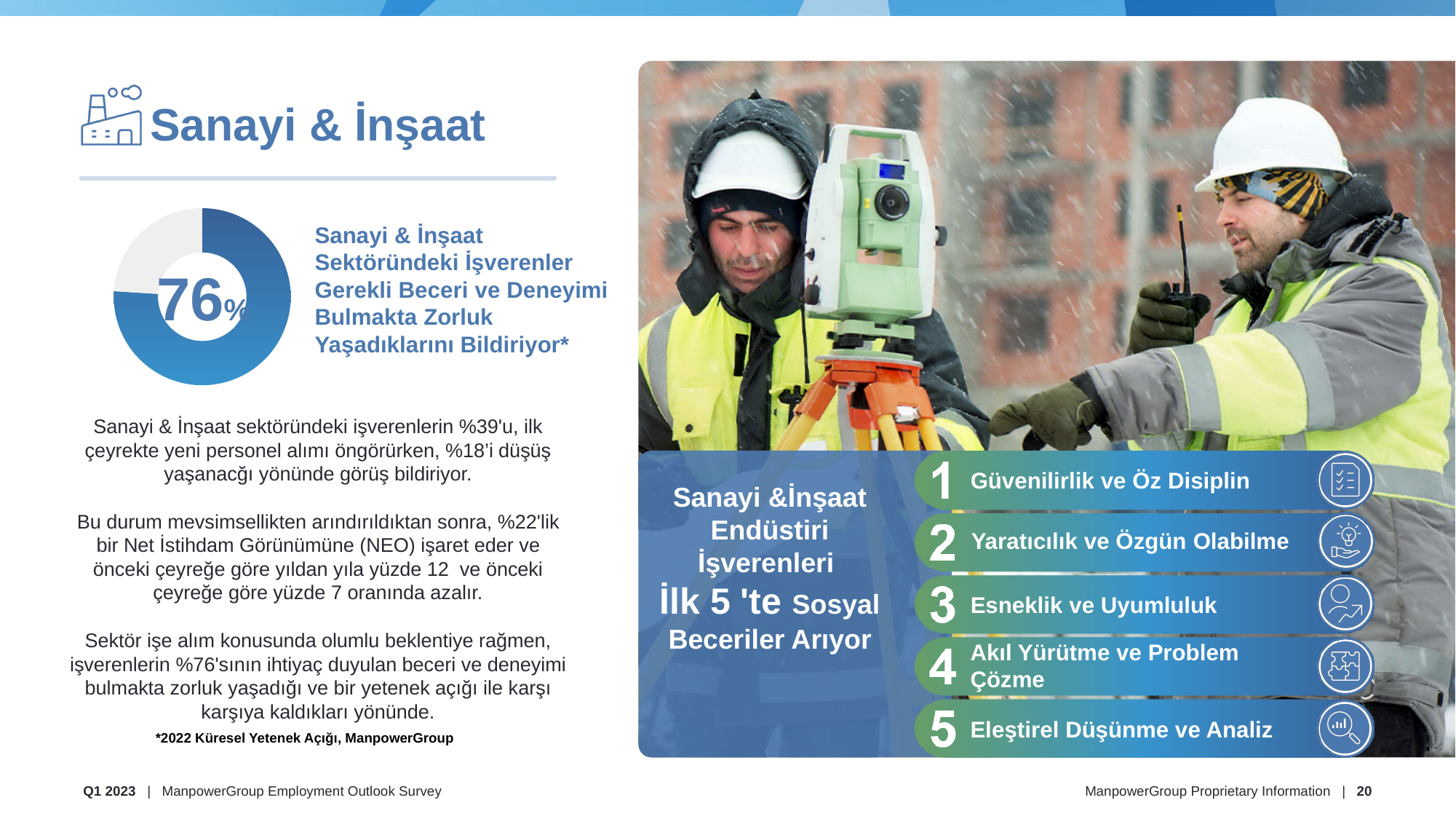
Is the value shown in the donut chart greater or less than 50%? greater What percentage is shown in the centre of the donut chart? 76% According to the text next to the donut chart, what does the 76% represent? Sanayi & İnşaat sektöründeki işverenlerin gerekli beceri ve deneyimi bulmakta zorluk yaşadıklarını bildirme oranı Which segment of the donut chart is larger, the dark blue filled segment or the light grey segment? The dark blue filled segment How many segments does the donut chart have? 2 What share of the donut chart is filled in dark blue? 76% What share of the donut chart is left unfilled (light grey)? 24% What source is cited below the donut chart text? *2022 Küresel Yetenek Açığı, ManpowerGroup What kind of chart is shown on the left of the slide? Donut (pie) chart